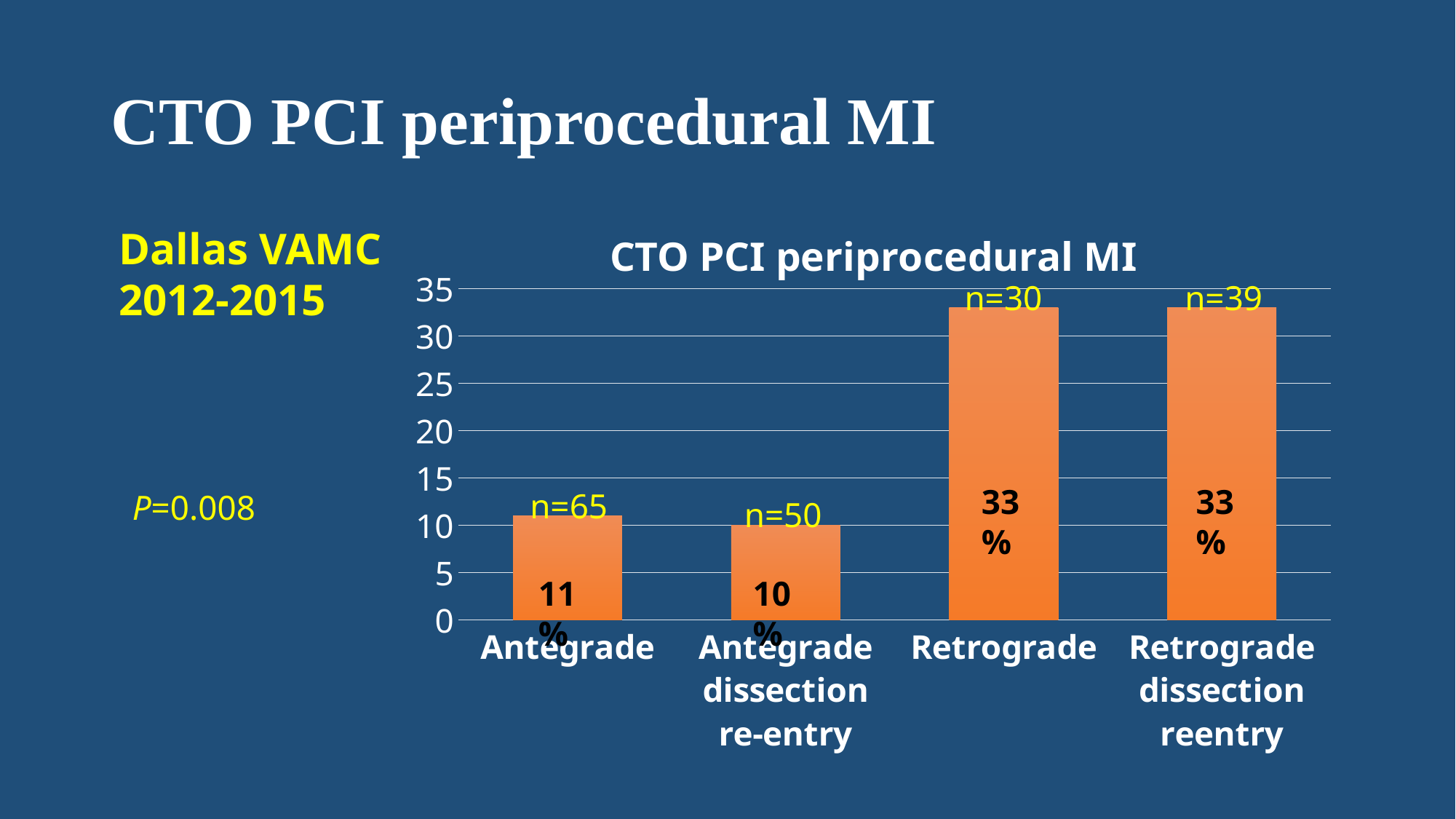
What is the periprocedural MI rate for Retrograde? 33% What is the periprocedural MI rate for Retrograde dissection reentry? 33% Is the value for Retrograde dissection reentry greater or less than 30? greater Which has a higher periprocedural MI rate, Antegrade or Retrograde? Retrograde What is the title of the chart? CTO PCI periprocedural MI What is the n value shown for the Antegrade bar? n=65 What is the periprocedural MI rate for Antegrade? 11% What is the periprocedural MI rate for Antegrade dissection re-entry? 10% What is the difference in periprocedural MI rate between Retrograde and Antegrade? 22% How many categories are shown on the x axis? 4 Which category has the lowest periprocedural MI rate? Antegrade dissection re-entry What kind of chart is shown? Bar chart